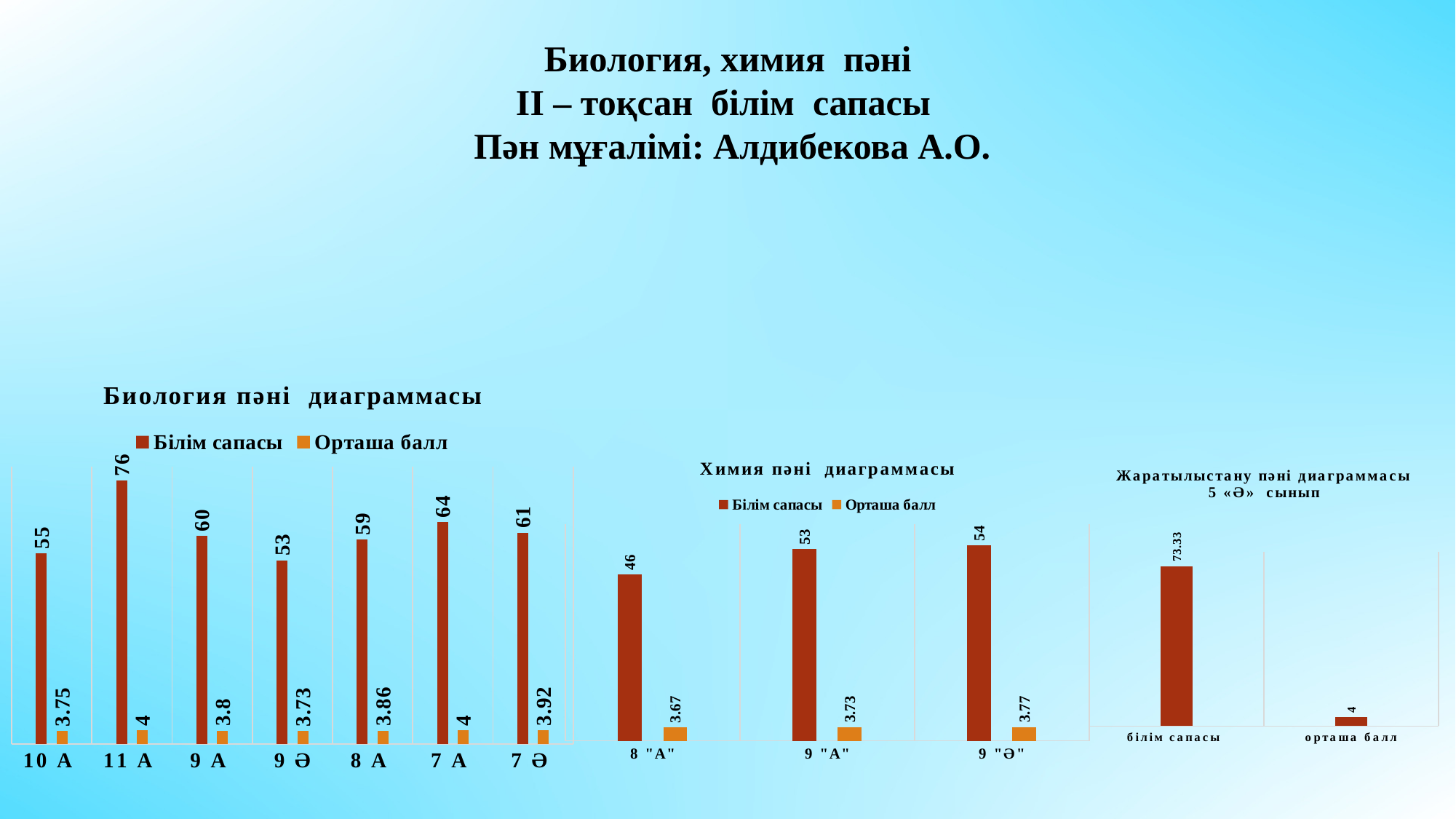
In the 'Биология пәні диаграммасы' chart, which class has the highest 'Білім сапасы' value? 11 А What kind of chart is the 'Жаратылыстану пәні диаграммасы 5 «Ә» сынып' chart? bar chart In the 'Химия пәні диаграммасы' chart, what is the 'Орташа балл' value for 9 "Ә"? 3.77 In the 'Биология пәні диаграммасы' chart, what is the difference between the 'Білім сапасы' values for 11 А and 10 А? 21 In the 'Биология пәні диаграммасы' chart, how many classes are shown on the x axis? 7 In the 'Жаратылыстану пәні диаграммасы 5 «Ә» сынып' chart, what is the value for 'білім сапасы'? 73.33 In the 'Химия пәні диаграммасы' chart, which class has the lowest 'Білім сапасы' value? 8 "А" In the 'Химия пәні диаграммасы' chart, how many series does the legend list? 2 In the 'Биология пәні диаграммасы' chart, what is the 'Орташа балл' value for 7 Ә? 3.92 In the 'Химия пәні диаграммасы' chart, what is the 'Білім сапасы' value for 8 "А"? 46 In the 'Биология пәні диаграммасы' chart, what is the 'Білім сапасы' value for 11 А? 76 In the 'Биология пәні диаграммасы' chart, which class has the lowest 'Білім сапасы' value? 9 Ә